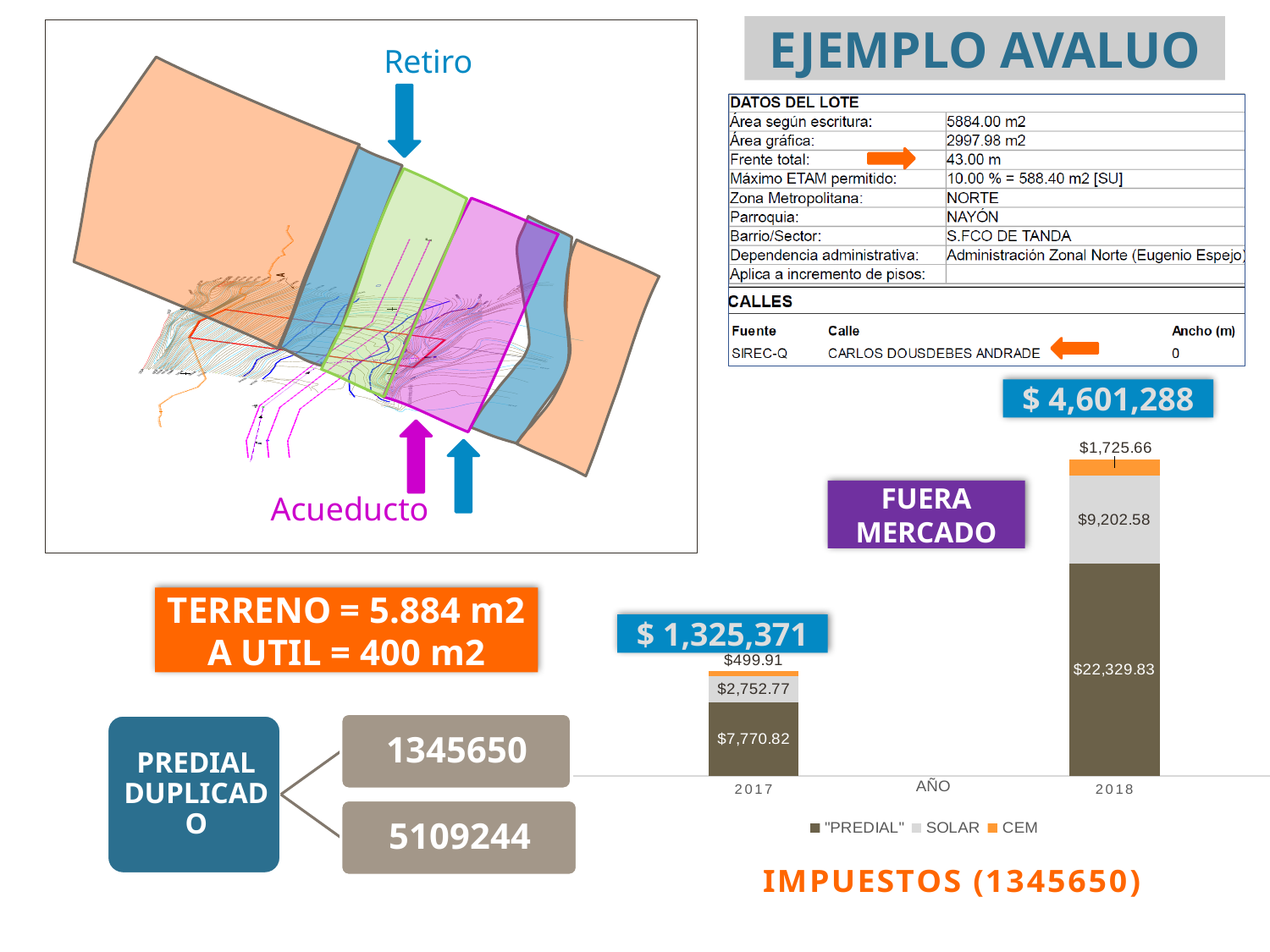
By how much did the "PREDIAL" value increase from 2017 to 2018? $14,559.01 What is the total of the stacked bar for 2017? $11,023.50 What is the total of the stacked bar for 2018? $33,258.07 How many years (categories) are shown on the x axis of the chart? 2 What is the title of the x axis of the chart? AÑO What type of chart is shown at the bottom right of the slide? Stacked bar chart What is the value of CEM for 2017 in the chart? $499.91 What is the value of SOLAR for 2018 in the chart? $9,202.58 How many series does the chart legend list? 3 What is the value of "PREDIAL" for 2017 in the chart? $7,770.82 Which year has the larger SOLAR value, 2017 or 2018? 2018 What is the value of "PREDIAL" for 2018 in the chart? $22,329.83